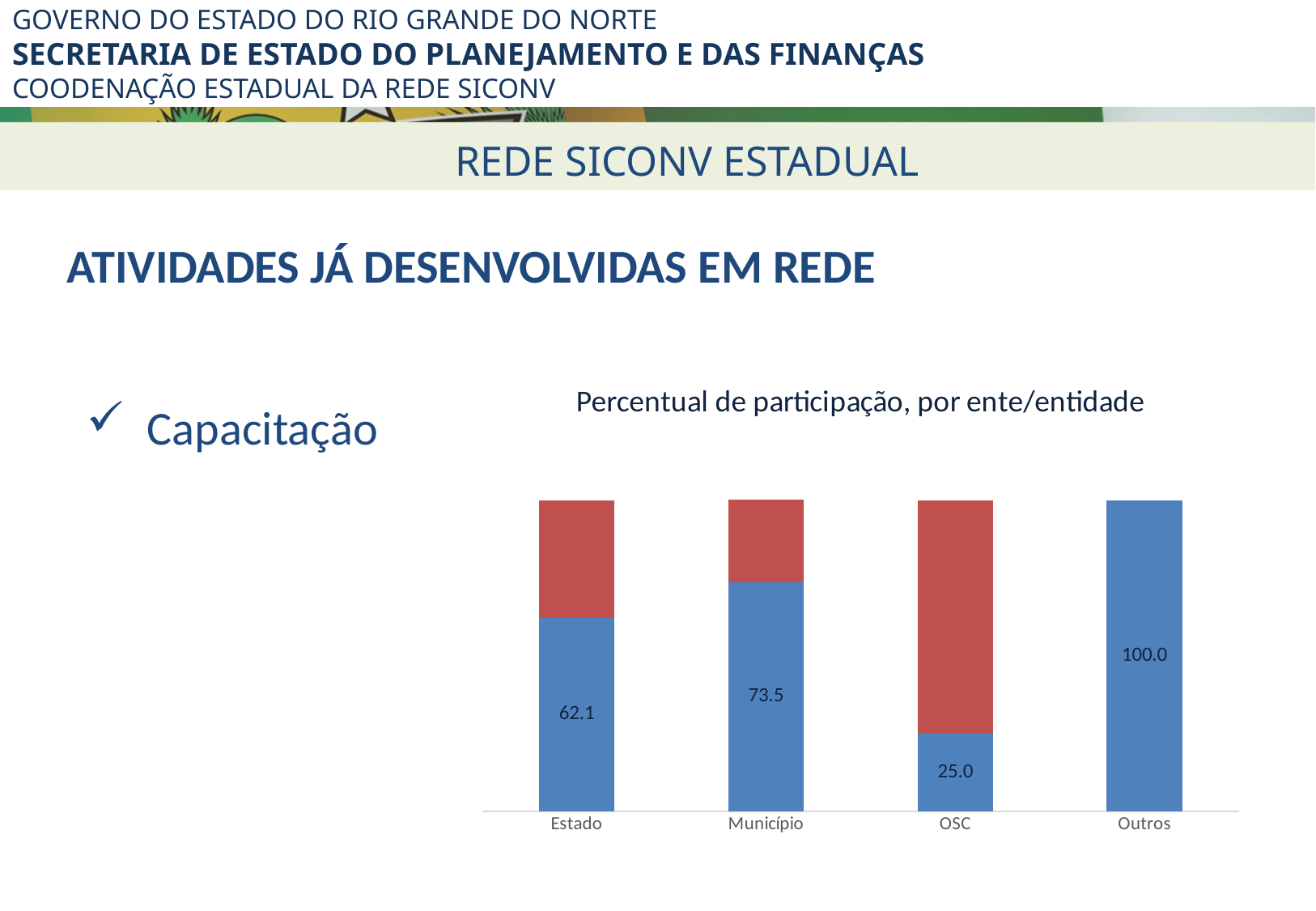
What is the blue value shown for Estado? 62.1 Which category has the lowest labelled blue value? OSC What is the blue value shown for Outros? 100.0 Which category has the highest labelled blue value? Outros How many categories are shown on the x axis of the chart? 4 What is the difference between the blue values for Outros and OSC? 75.0 What kind of chart is shown on the slide? Stacked bar chart What is the title of the chart? Percentual de participação, por ente/entidade What is the blue value shown for OSC? 25.0 What is the difference between the blue values for Município and Estado? 11.4 What is the blue value shown for Município? 73.5 Which has a larger blue value, Estado or OSC? Estado